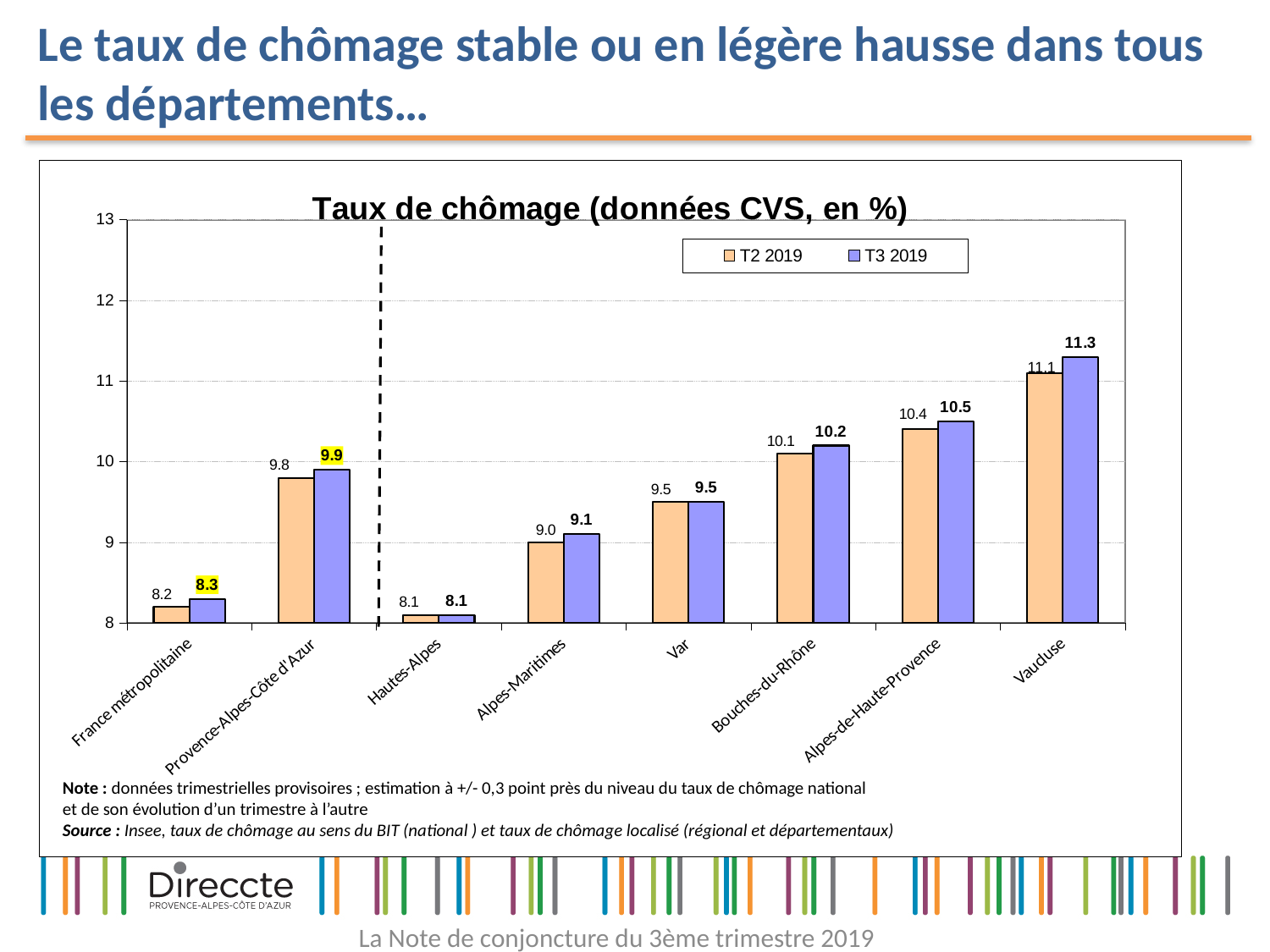
Which category has the lowest T2 2019 unemployment rate? Hautes-Alpes Which is larger: the T3 2019 value for Var or the T3 2019 value for Alpes-Maritimes? Var What is the T3 2019 value for Bouches-du-Rhône? 10.2 How many series does the legend list? 2 Is the T3 2019 value for Bouches-du-Rhône greater or less than 10? greater Which category has the highest T3 2019 unemployment rate? Vaucluse What type of chart is shown? bar chart What is the T3 2019 unemployment rate for Vaucluse? 11.3 What is the T2 2019 value for Provence-Alpes-Côte d'Azur? 9.8 What is the difference between the T3 2019 and T2 2019 values for Vaucluse? 0.2 What is the difference between the T3 2019 values for Alpes-de-Haute-Provence and Alpes-Maritimes? 1.4 How many categories are shown on the x axis? 8